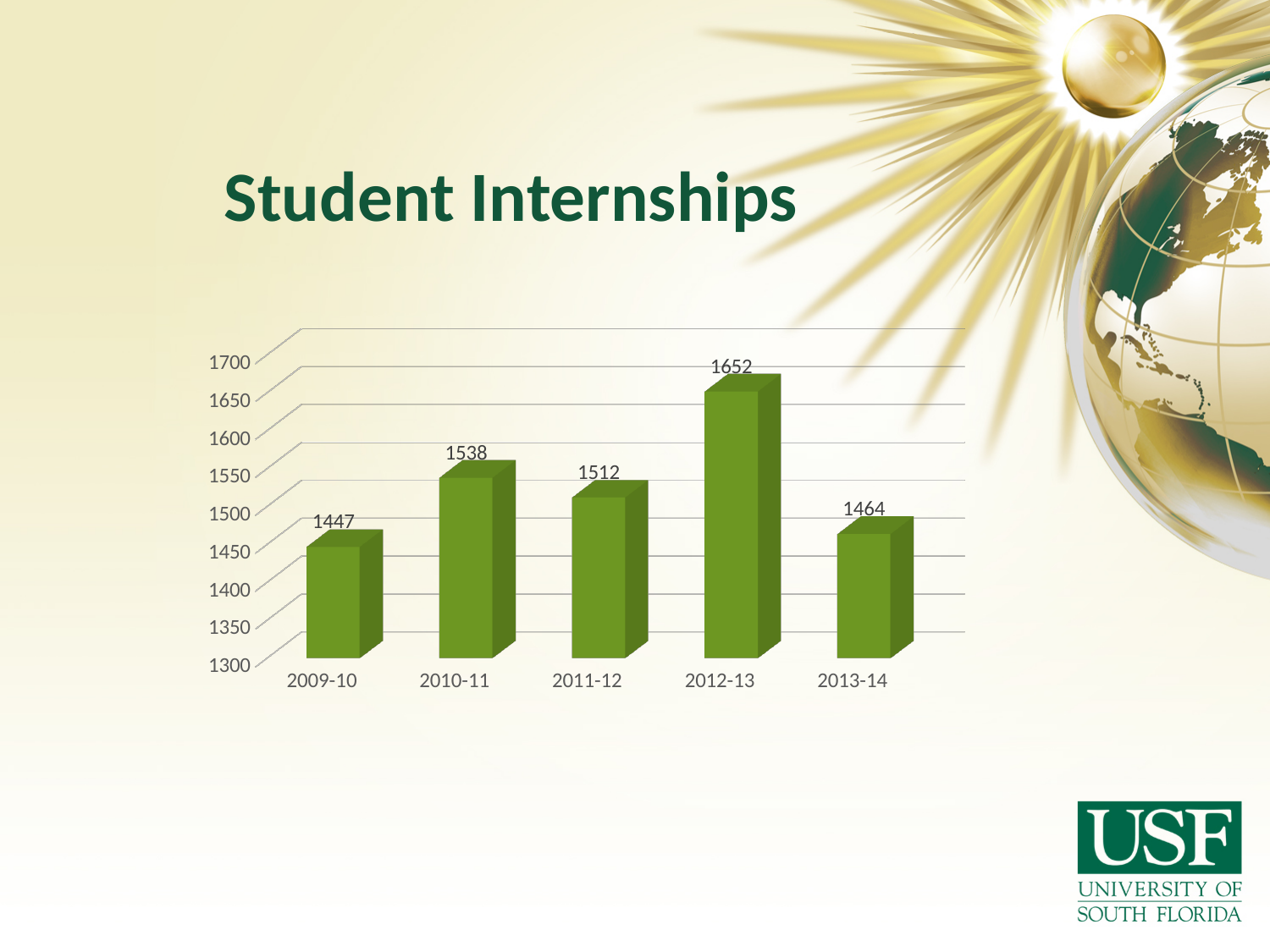
Which year has the lowest value? 2009-10 What is the difference between the values for 2010-11 and 2011-12? 26 Which is larger, the value for 2010-11 or the value for 2011-12? 2010-11 Is the value for 2012-13 greater or less than 1600? greater Which year has the highest value? 2012-13 What is the difference between the values for 2012-13 and 2013-14? 188 What is the value for 2012-13? 1652 What is the value for 2009-10? 1447 How many years are shown on the x axis? 5 What kind of chart is shown on the slide? bar chart What is the title of the slide containing the chart? Student Internships What is the value for 2013-14? 1464